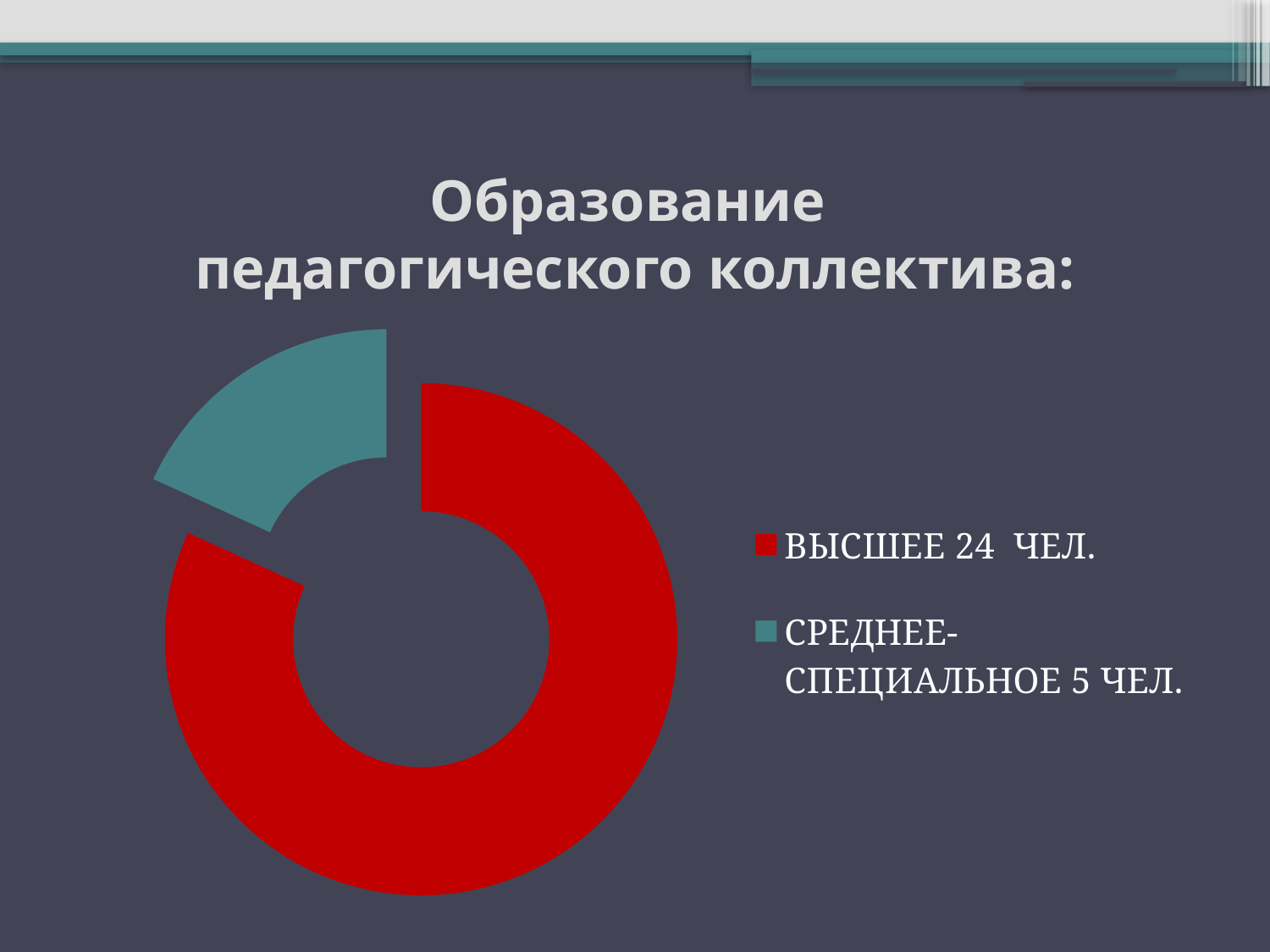
What is the difference between the number of staff with higher education and the number with secondary specialised education? 19 How many people have secondary specialised education (СРЕДНЕЕ-СПЕЦИАЛЬНОЕ) according to the chart? 5 Which category has the smallest slice of the chart? СРЕДНЕЕ-СПЕЦИАЛЬНОЕ How many categories does the chart show? 2 What is the total number of people represented in the chart? 29 How many people in the teaching staff have higher education (ВЫСШЕЕ) according to the chart? 24 What colour represents the ВЫСШЕЕ category in the chart? Red Which is larger: the number of staff with ВЫСШЕЕ education or with СРЕДНЕЕ-СПЕЦИАЛЬНОЕ education? ВЫСШЕЕ What kind of chart is shown on the slide? Doughnut (pie) chart What is the title of the slide containing the chart? Образование педагогического коллектива: Which category has the largest slice of the chart? ВЫСШЕЕ How many entries does the legend list? 2